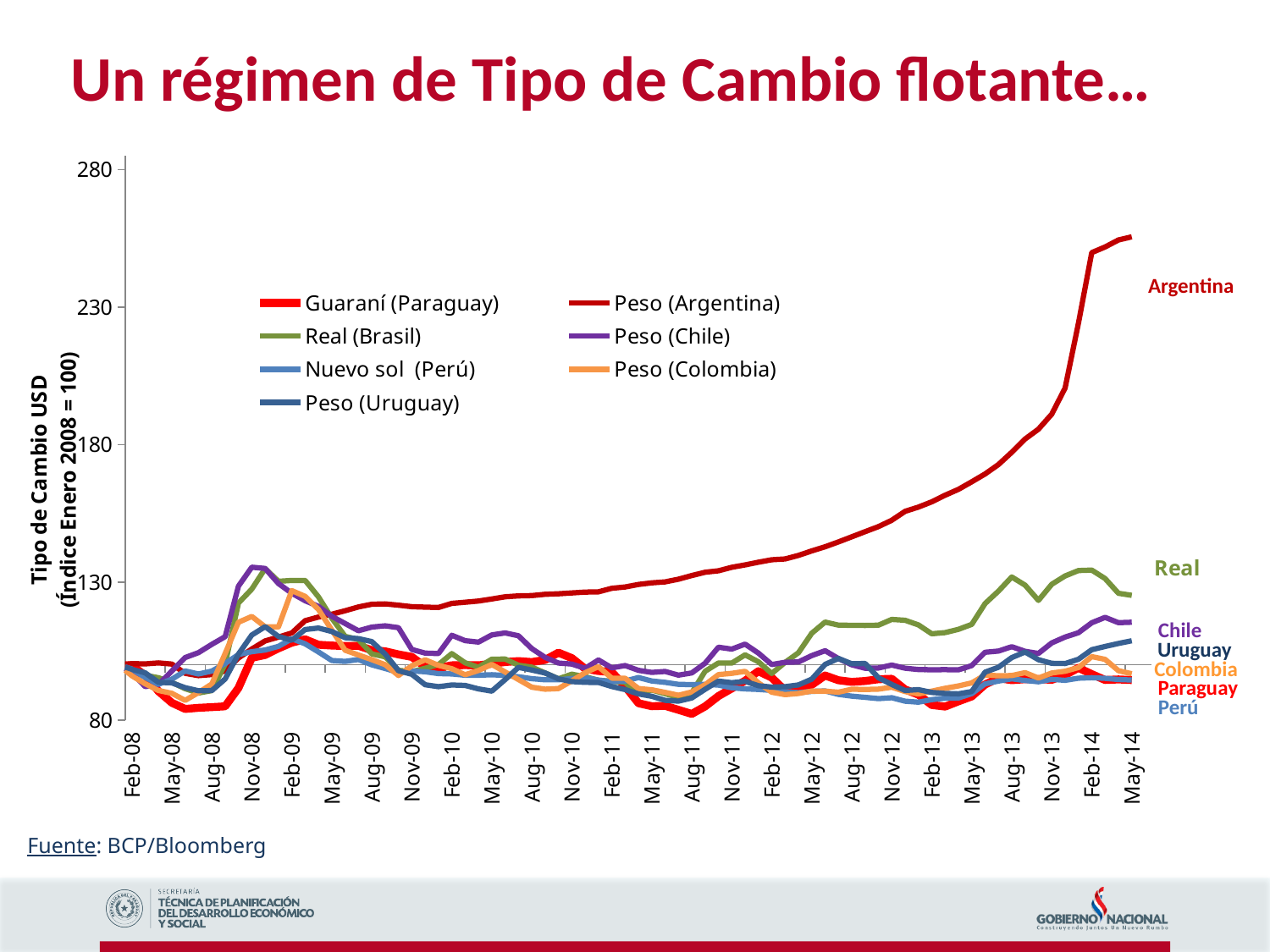
Which series has the highest value at May-14? Peso (Argentina) What kind of chart is shown on the slide? line chart Is the value for Peso (Argentina) at Nov-13 greater or less than 180? greater How many series does the legend list? 7 Which is larger at May-14, Peso (Argentina) or Real (Brasil)? Peso (Argentina) What is the title of the chart's vertical axis? Tipo de Cambio USD (Índice Enero 2008 = 100) Does the Peso (Argentina) series rise or fall from Feb-12 to May-14? rise Which is larger at Feb-09, Real (Brasil) or Peso (Argentina)? Real (Brasil) Is the value for Peso (Argentina) at May-14 greater or less than 230? greater Which series has the lowest value at Aug-11? Guaraní (Paraguay) Is the value for Peso (Argentina) at Nov-12 greater or less than 130? greater